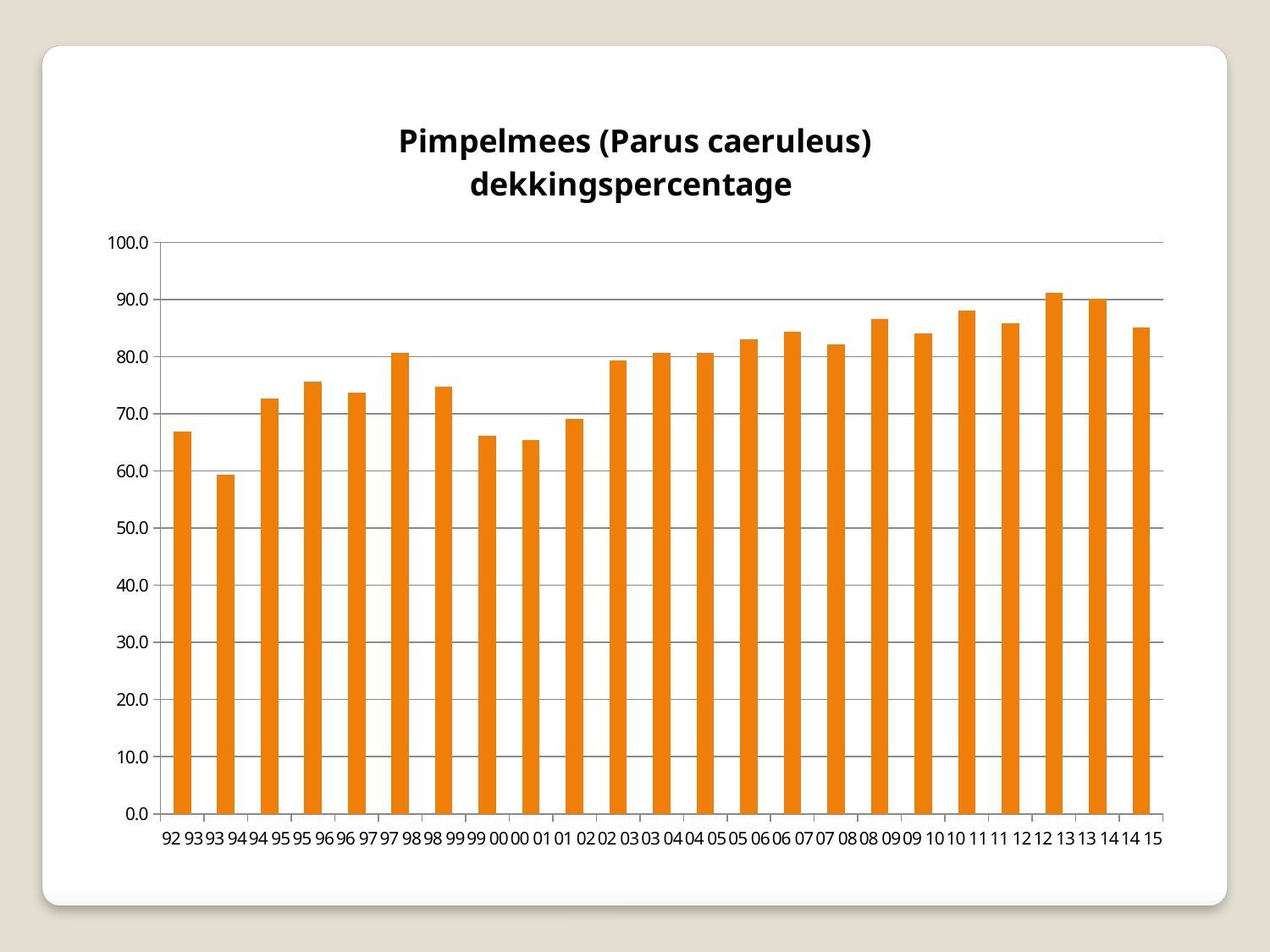
What kind of chart is shown on the slide? bar chart Which period has the lowest bar? 93 94 Which period has the highest bar? 12 13 Is the value for 00 01 greater or less than 70.0? less Is the value for 93 94 greater or less than 60.0? less How many bars are plotted in the chart? 23 Do the values generally rise or fall from 92 93 to 14 15? rise What is the title of the chart? Pimpelmees (Parus caeruleus) dekkingspercentage Which is larger, the value for 93 94 or the value for 94 95? 94 95 Is the value for 10 11 greater or less than 80.0? greater Which is larger, the value for 97 98 or the value for 98 99? 97 98